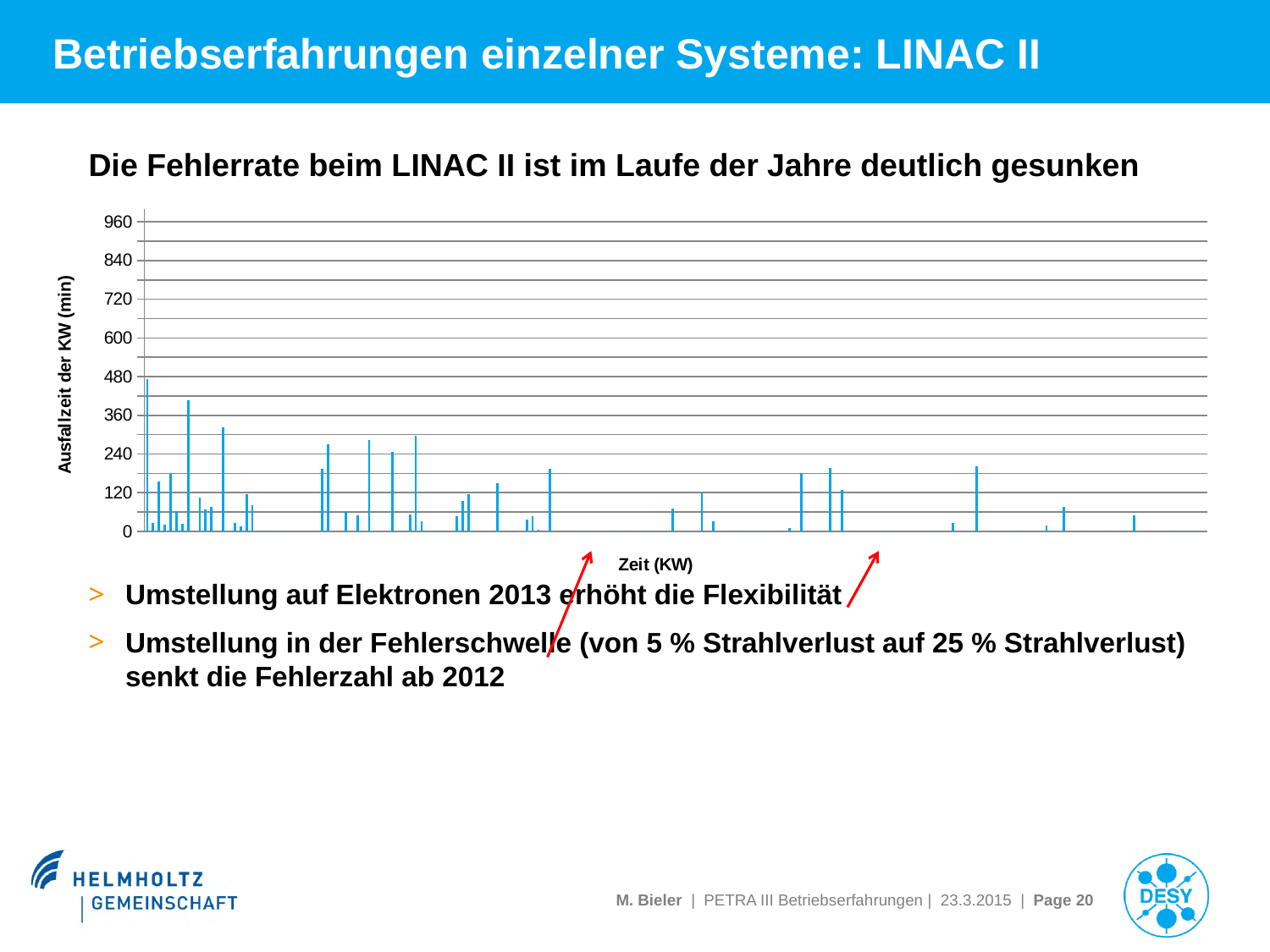
Is the tallest bar in the chart greater or less than 600? less Is the tallest bar in the right half of the chart greater or less than 240? less What kind of chart is shown on the slide? bar chart Do the bar heights generally rise or fall from left to right along the x axis? fall Does any bar in the chart reach above 720? no What is the title of the vertical axis of the chart? Ausfallzeit der KW (min) What is the title of the horizontal axis of the chart? Zeit (KW)